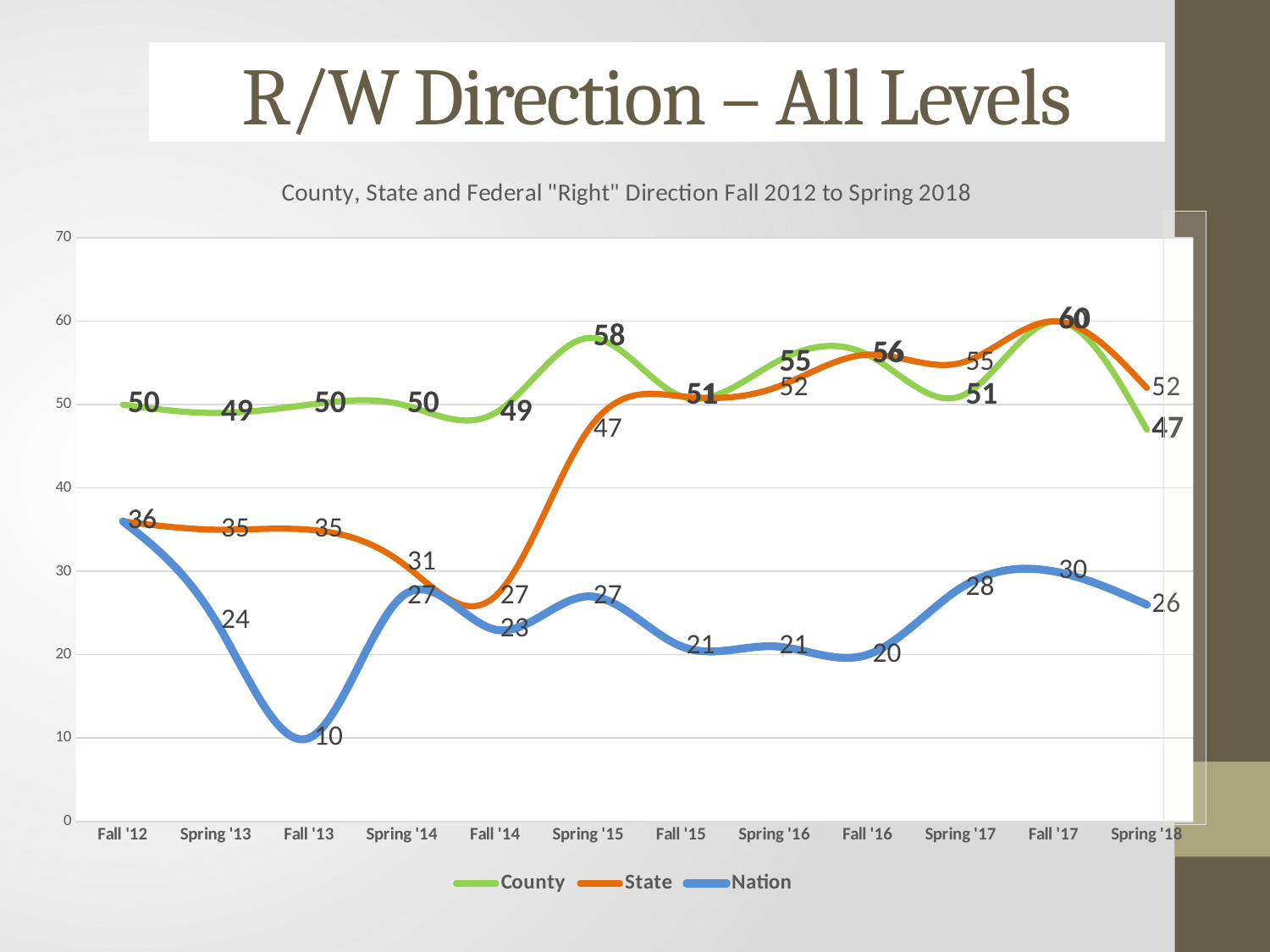
How many time points are shown along the x axis? 12 At which time point is the Nation series at its lowest? Fall '13 At which time point does the County series reach its highest value? Fall '17 What colour is the Nation line in the chart? Blue In Spring '14, which is larger, the State value or the Nation value? State Does the State series rise or fall from Fall '14 to Fall '17? Rise What is the State value for Spring '18? 52 What is the difference between the State and County values in Spring '18? 5 What is the County value for Spring '15? 58 What is the Nation value for Fall '13? 10 How many series does the legend list? 3 What kind of chart is shown on the slide? Line chart